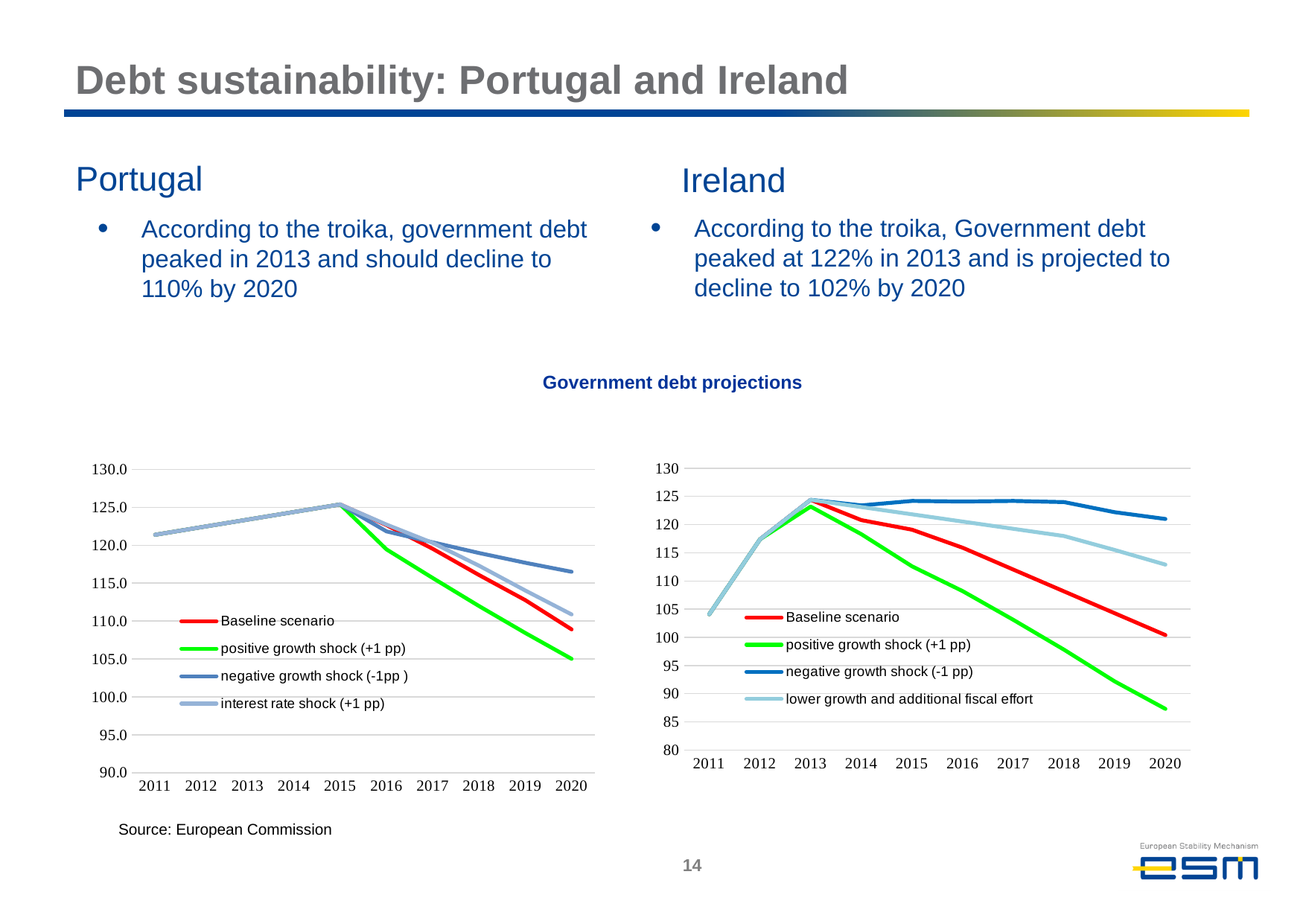
What kind of chart is the left chart (Portugal) under 'Government debt projections'? line chart How many years are shown on the x axis of the left chart (Portugal)? 10 In the left chart (Portugal), which series has the lowest value in 2020? positive growth shock (+1 pp) In the right chart (Ireland), does the Baseline scenario rise or fall from 2013 to 2020? fall How many series does the legend of the right chart (Ireland) list? 4 In the right chart (Ireland), is the value for the positive growth shock (+1 pp) series in 2020 greater or less than 90? less In the right chart (Ireland), which series has the lowest value in 2020? positive growth shock (+1 pp) In the left chart (Portugal), is the value for the positive growth shock (+1 pp) series in 2020 greater or less than 110.0? less What is the name of the fourth legend entry in the left chart (Portugal)? interest rate shock (+1 pp) In the right chart (Ireland), which is larger in 2020: the Baseline scenario or the lower growth and additional fiscal effort series? lower growth and additional fiscal effort In the left chart (Portugal), is the value for the negative growth shock (-1pp ) series in 2020 greater or less than 115.0? greater In the left chart (Portugal), which series has the highest value in 2020? negative growth shock (-1pp )